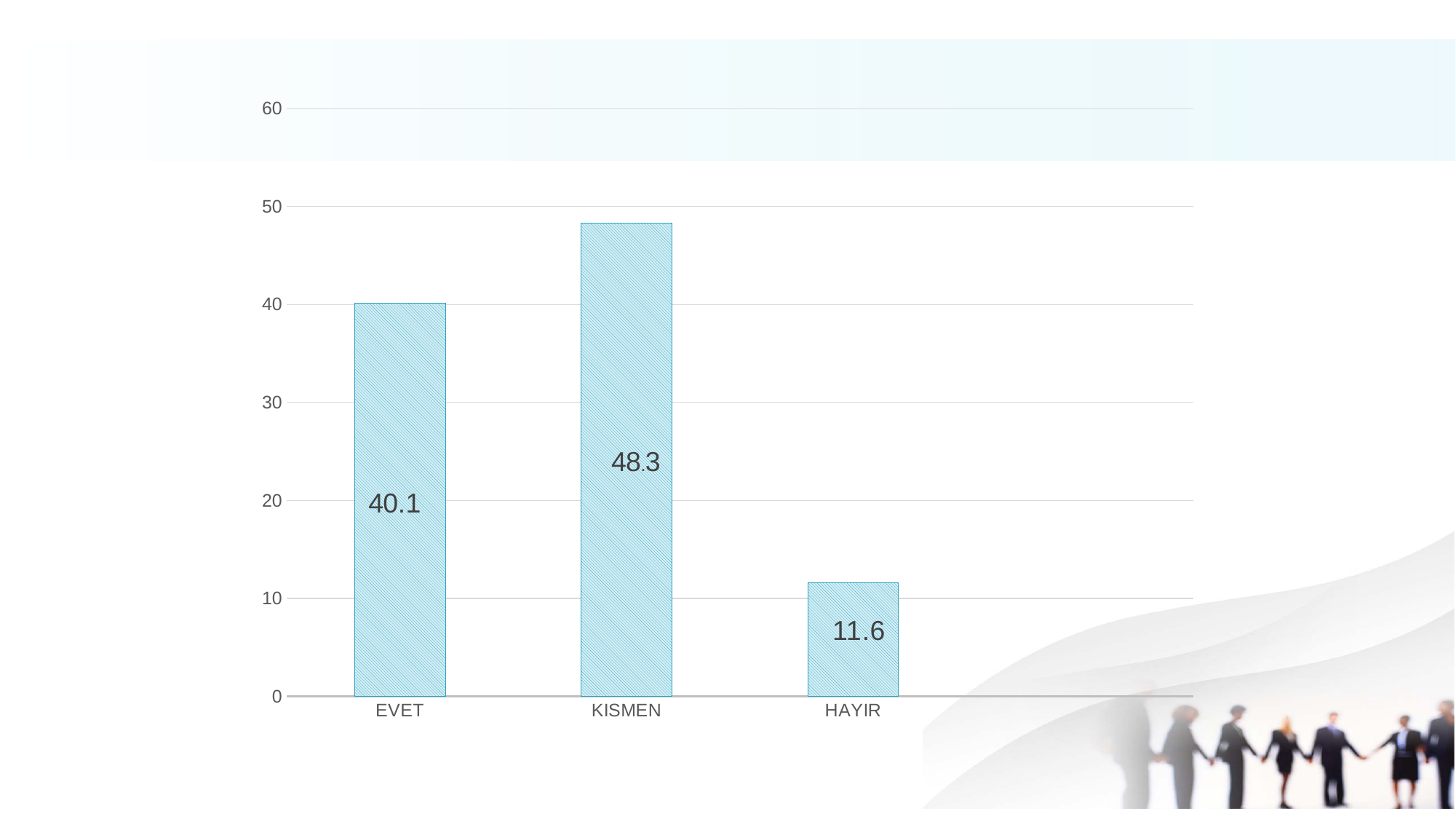
What is the difference between the values for EVET and HAYIR? 28.5 What is the value for EVET? 40.1 Which category has the lowest value? HAYIR Which category has the highest value? KISMEN What is the value for HAYIR? 11.6 What is the highest value shown on the vertical axis? 60 How many categories are shown on the x axis? 3 What kind of chart is shown on the slide? bar chart What is the value for KISMEN? 48.3 Is the value for KISMEN greater or less than 50? less Which is larger, the value for EVET or the value for HAYIR? EVET What is the difference between the values for KISMEN and EVET? 8.2